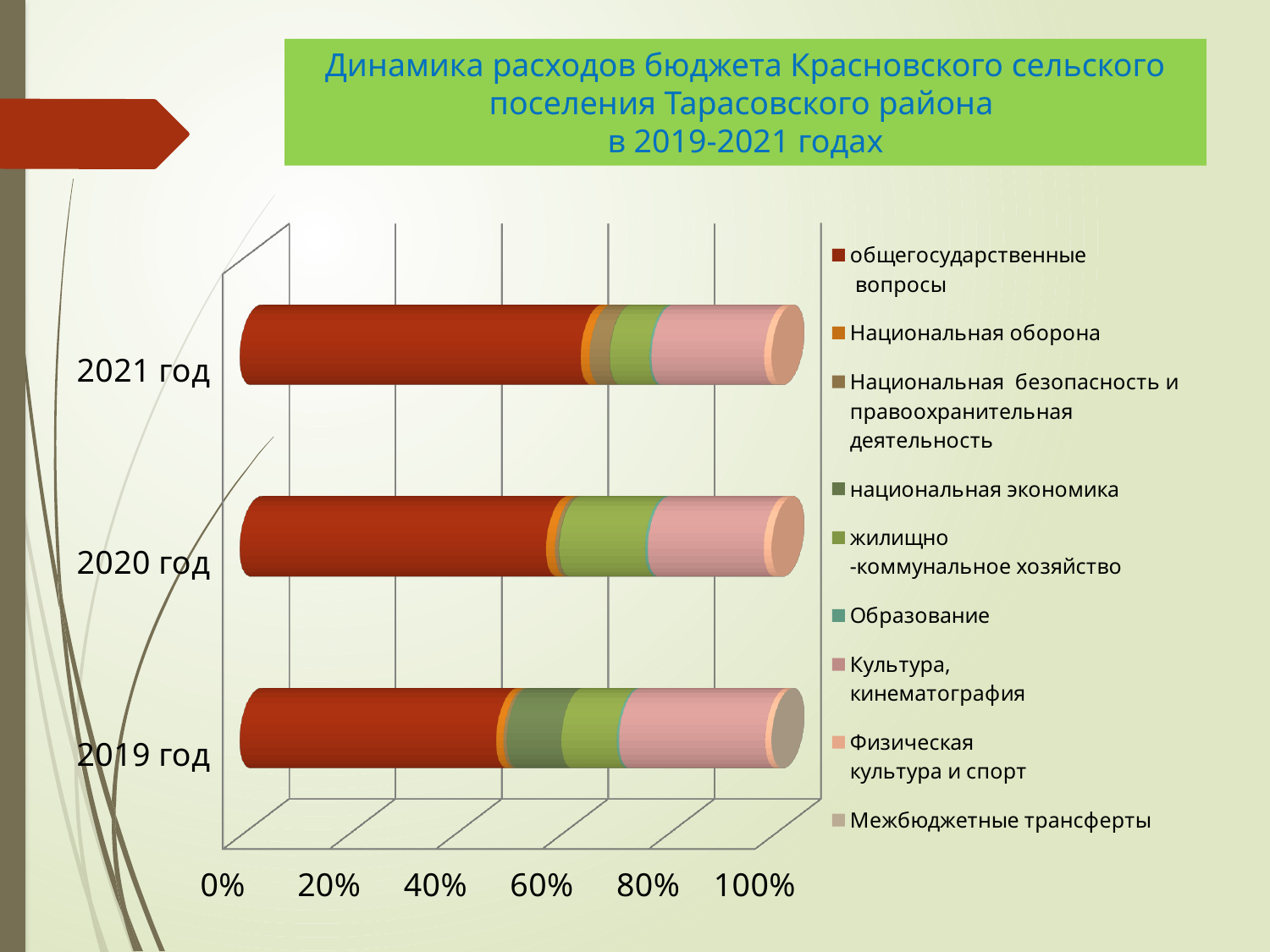
Which year has the larger share of общегосударственные вопросы, 2019 год or 2021 год? 2021 год Which legend entry is shown in dark red, the first segment of each bar? общегосударственные вопросы Which year has the larger share of Культура, кинематография, 2019 год or 2021 год? 2019 год What kind of chart is shown on the slide? Stacked bar chart What is the title of the chart on the slide? Динамика расходов бюджета Красновского сельского поселения Тарасовского района в 2019-2021 годах How many series does the legend list? 9 How many years (categories) are plotted on the chart? 3 Is the share of общегосударственные вопросы in 2021 год greater or less than 40%? greater Does the share of общегосударственные вопросы rise or fall from 2019 год to 2021 год? rise Is the share of общегосударственные вопросы in 2019 год greater or less than 60%? less Is the share of общегосударственные вопросы in 2020 год greater or less than 40%? greater In which year is the share of общегосударственные вопросы the smallest? 2019 год